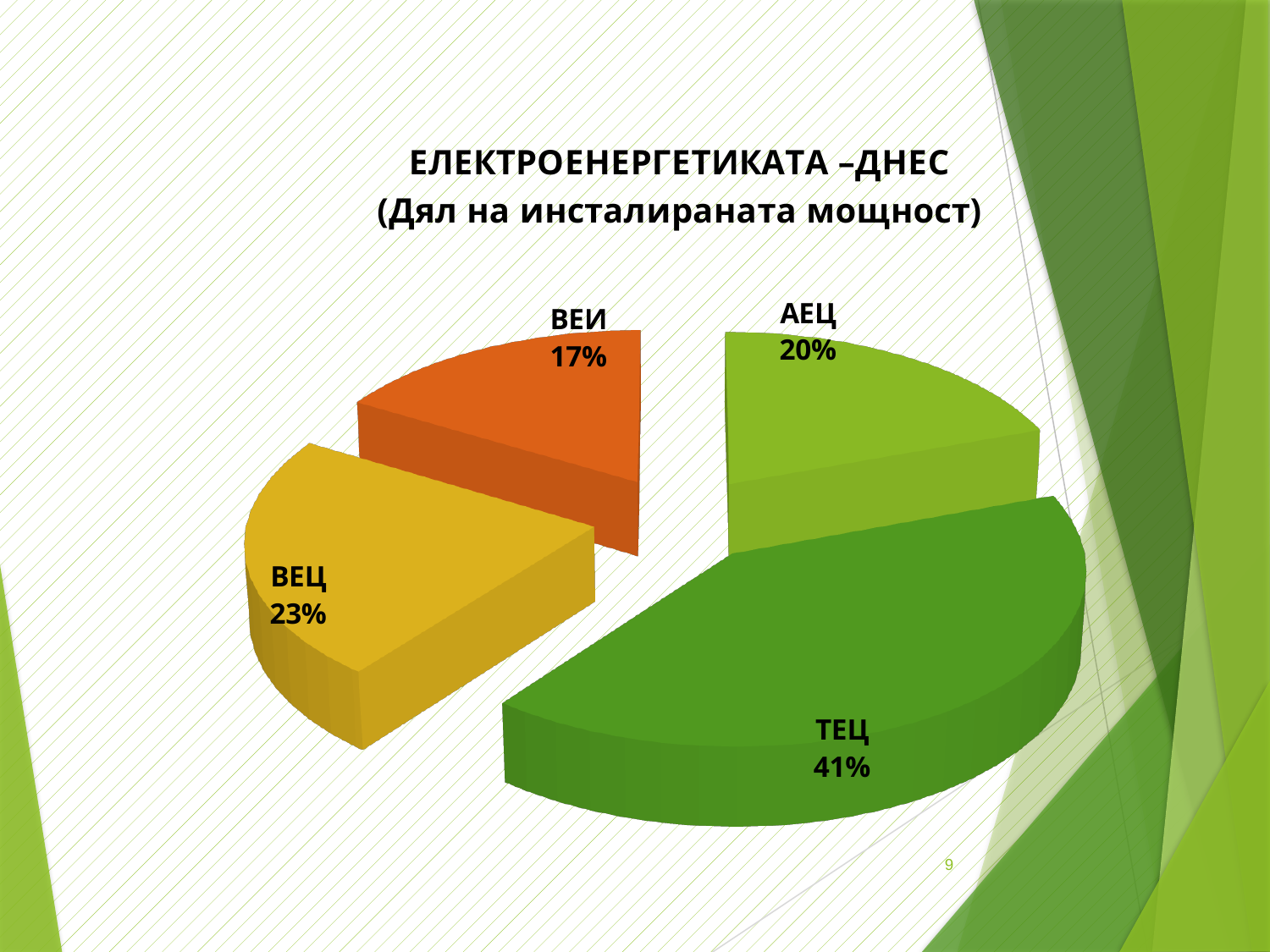
How many categories are shown in the pie chart? 4 What is the title of the chart? ЕЛЕКТРОЕНЕРГЕТИКАТА –ДНЕС (Дял на инсталираната мощност) What colour is the slice for ВЕИ? Orange What share of installed capacity does ВЕЦ hold? 23% Which category has the smallest share of installed capacity? ВЕИ What share of installed capacity does АЕЦ hold? 20% Which has a larger share, ВЕЦ or АЕЦ? ВЕЦ What share of installed capacity does ВЕИ hold? 17% What is the difference in percentage points between the shares of ТЕЦ and АЕЦ? 21 What kind of chart is shown on the slide? Pie chart What share of installed capacity does ТЕЦ hold? 41% Which category has the largest share of installed capacity? ТЕЦ